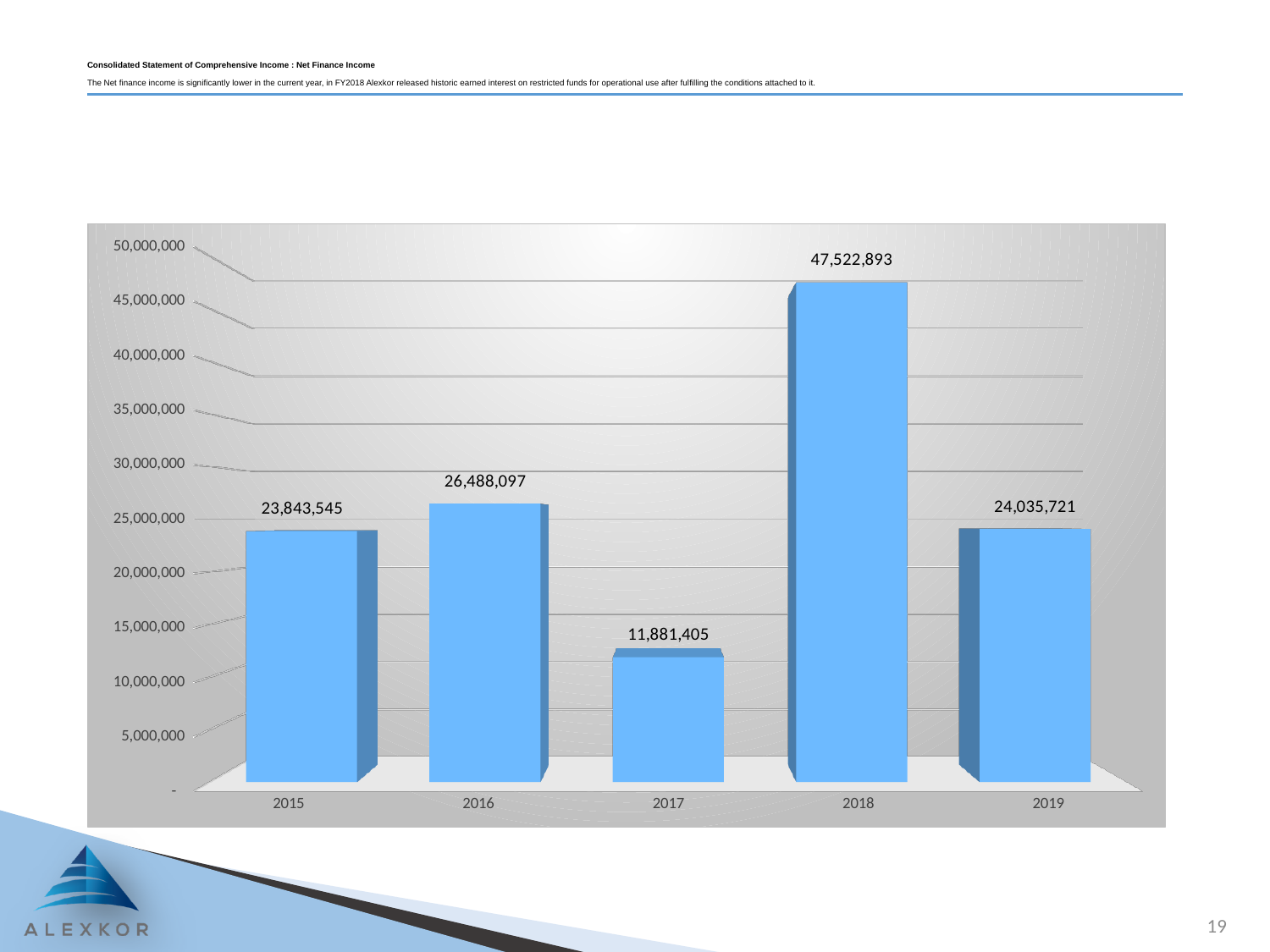
Which is larger, the value for 2016 or the value for 2019? 2016 What is the value for 2018? 47,522,893 What is the difference between the values for 2016 and 2015? 2,644,552 Which year has the lowest value? 2017 How many years are shown on the x axis? 5 Is the value for 2017 greater or less than 15,000,000? less What is the value for 2015? 23,843,545 What is the value for 2017? 11,881,405 Which year has the highest value? 2018 What kind of chart is shown on the slide? bar chart What is the value for 2019? 24,035,721 What is the difference between the values for 2018 and 2017? 35,641,488